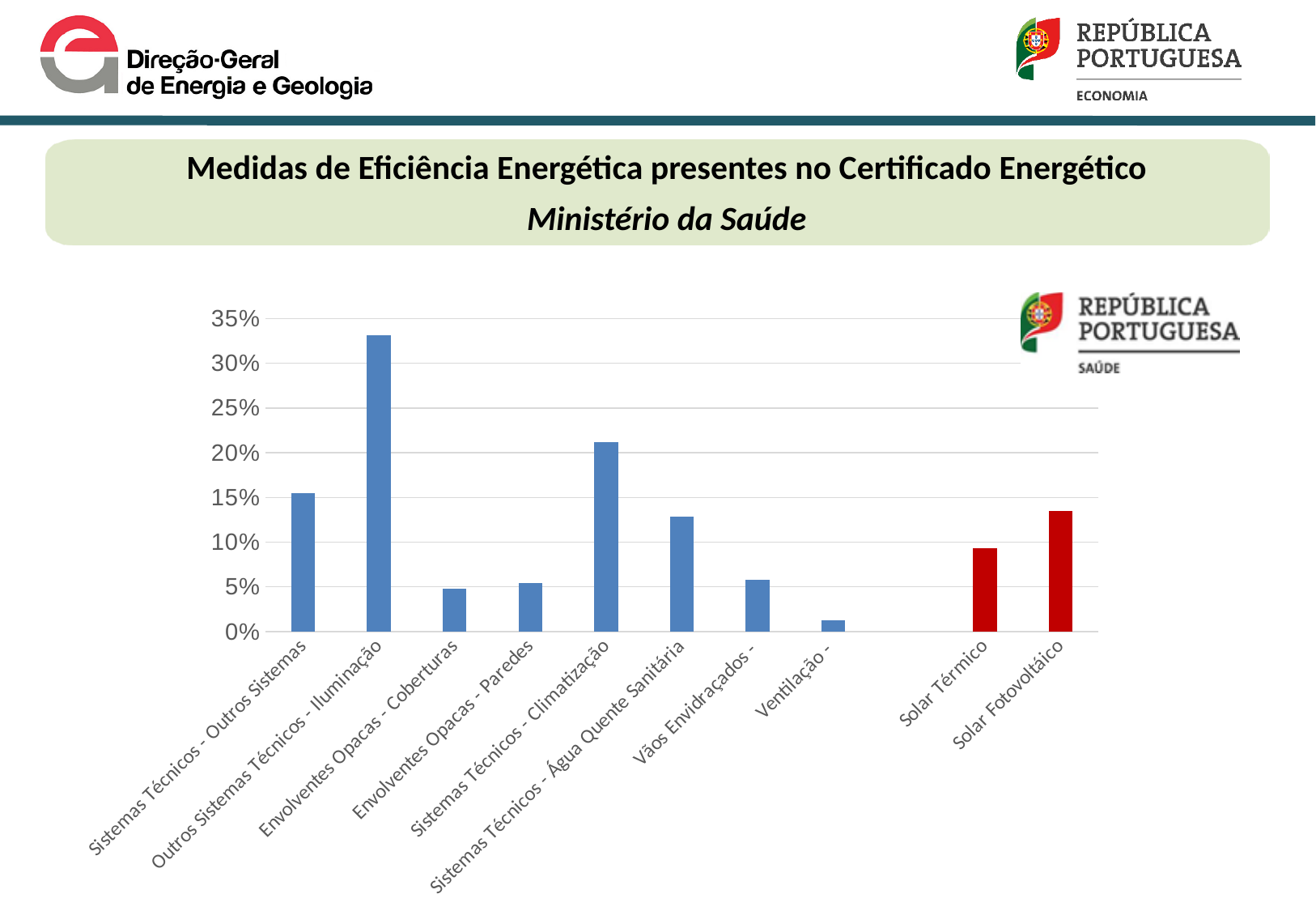
Which category has the highest value? Outros Sistemas Técnicos - Iluminação Which category has the lowest value? Ventilação - How many categories are plotted on the chart? 10 What kind of chart is shown on the slide? bar chart Is the value for Outros Sistemas Técnicos - Iluminação greater or less than 30%? greater Which is larger, Sistemas Técnicos - Climatização or Sistemas Técnicos - Água Quente Sanitária? Sistemas Técnicos - Climatização Is the value for Solar Térmico greater or less than 10%? less Which is larger, Solar Fotovoltáico or Solar Térmico? Solar Fotovoltáico How many bars on the chart are coloured red? 2 Is the value for Solar Fotovoltáico greater or less than 10%? greater